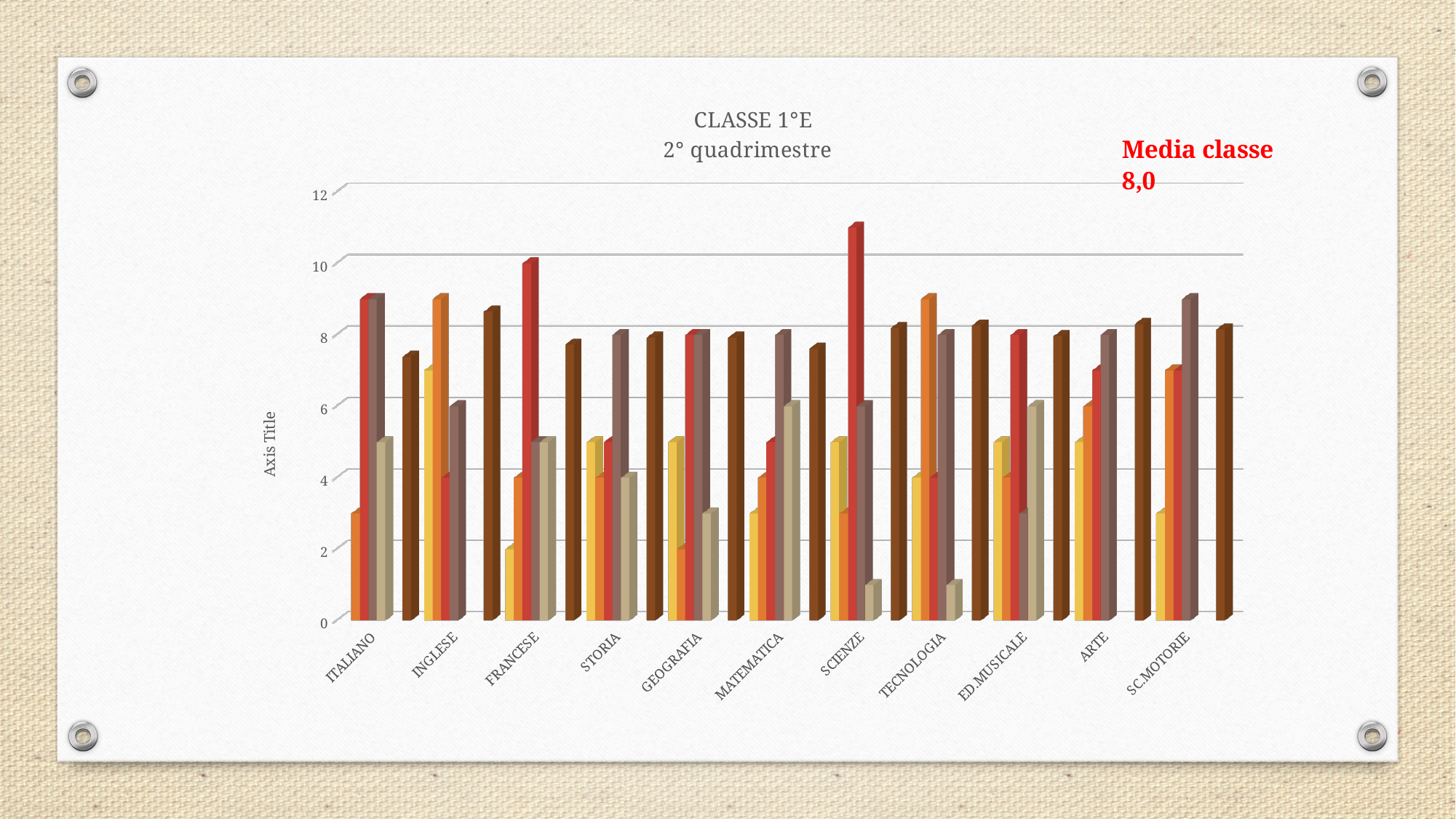
Is the tallest bar for SCIENZE greater or less than 10? greater What is the title of the chart? CLASSE 1°E 2° quadrimestre Is the tallest bar for FRANCESE greater or less than 8? greater Is the shortest bar for ITALIANO greater or less than 4? less What kind of chart is shown on the slide? bar chart How many subject categories are shown on the x axis of the chart? 11 Which subject has the single tallest bar in the chart? SCIENZE What is the label on the vertical axis of the chart? Axis Title